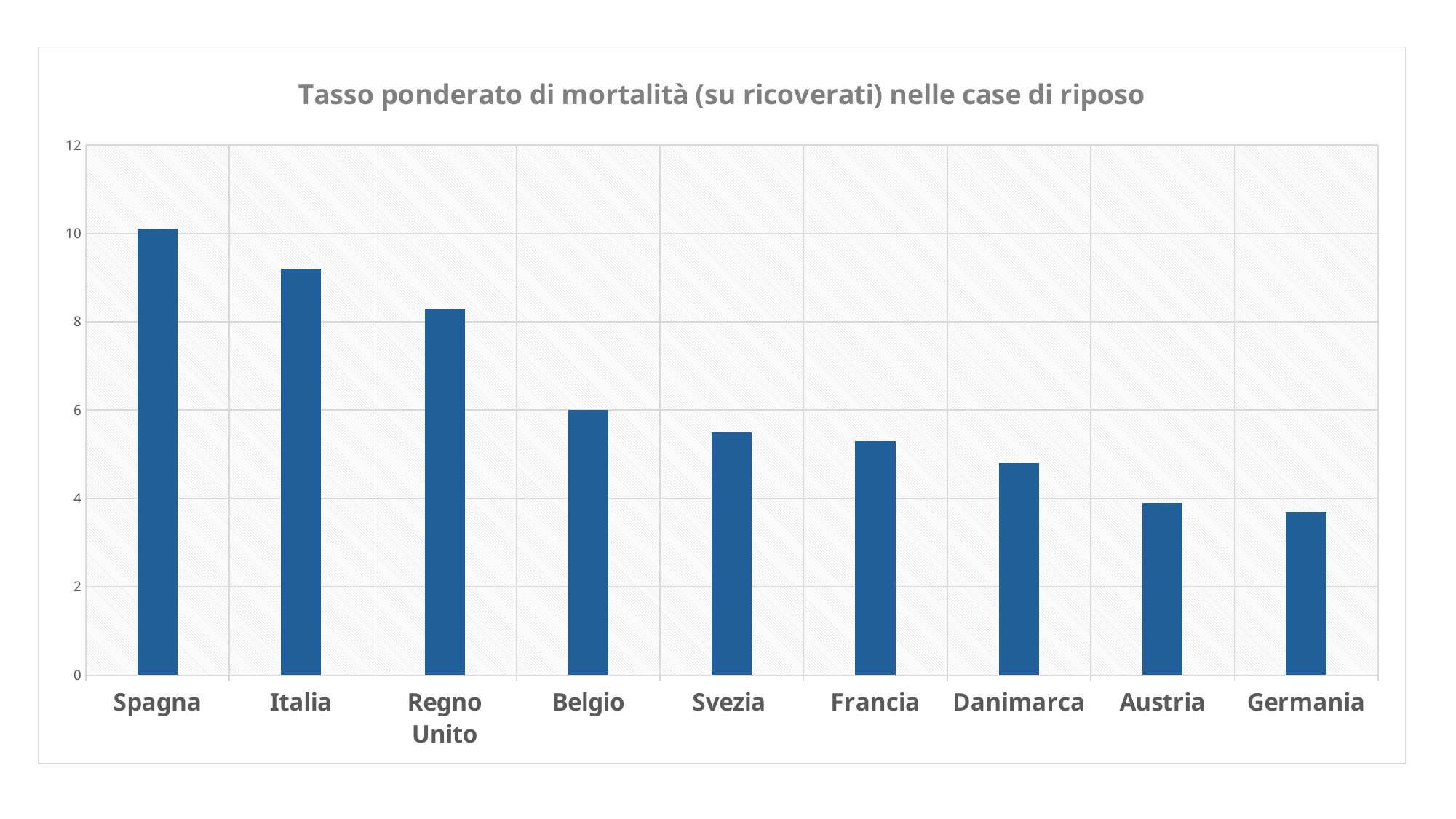
Which has a larger value, Francia or Austria? Francia Which country has the highest bar in the chart? Spagna Which has a larger value, Italia or Belgio? Italia Is the value for Danimarca greater or less than 4? greater What is the title of the chart? Tasso ponderato di mortalità (su ricoverati) nelle case di riposo How many countries are shown on the x axis of the chart? 9 Is the value for Regno Unito greater or less than 8? greater Is the value for Italia greater or less than 10? less Do the bar values rise or fall from left to right along the x axis? fall What type of chart is shown on the slide? bar chart